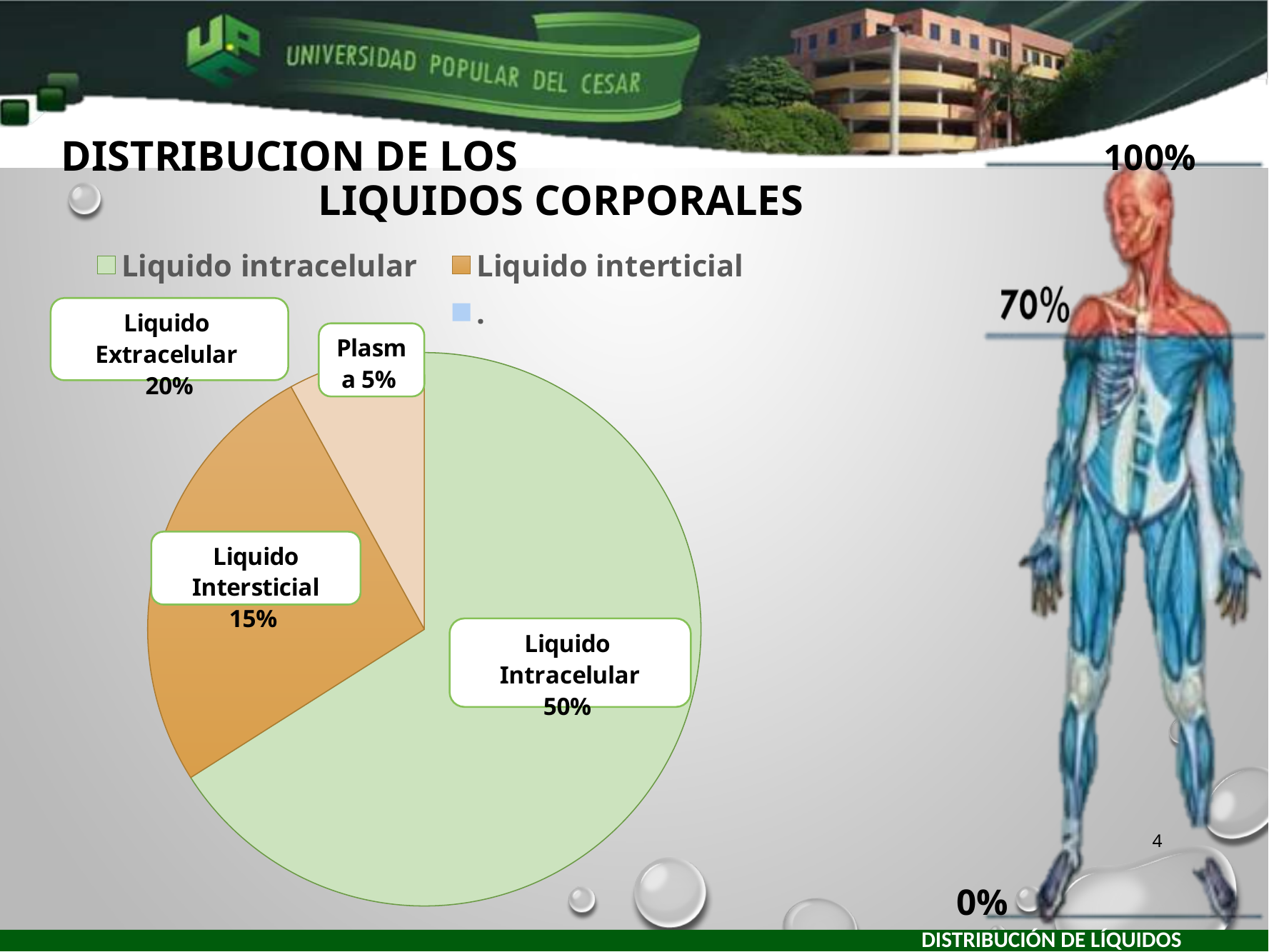
What is the difference between the Liquido Intracelular and Liquido Intersticial percentages? 35% Which slice of the pie chart is the largest? Liquido Intracelular What percentage is shown for Plasma in the pie chart? 5% What percentage is shown for Liquido Intracelular in the pie chart? 50% What percentage is shown for Liquido Intersticial in the pie chart? 15% Which slice of the pie chart is the smallest? Plasma What is the difference between the Liquido Intersticial and Plasma percentages? 10% What percentage is given for Liquido Extracelular on the slide? 20% What colour is the Liquido Intracelular slice in the pie chart? green What kind of chart is shown on the slide? pie chart How many slices does the pie chart have? 3 Which is larger, Liquido Intersticial or Plasma? Liquido Intersticial